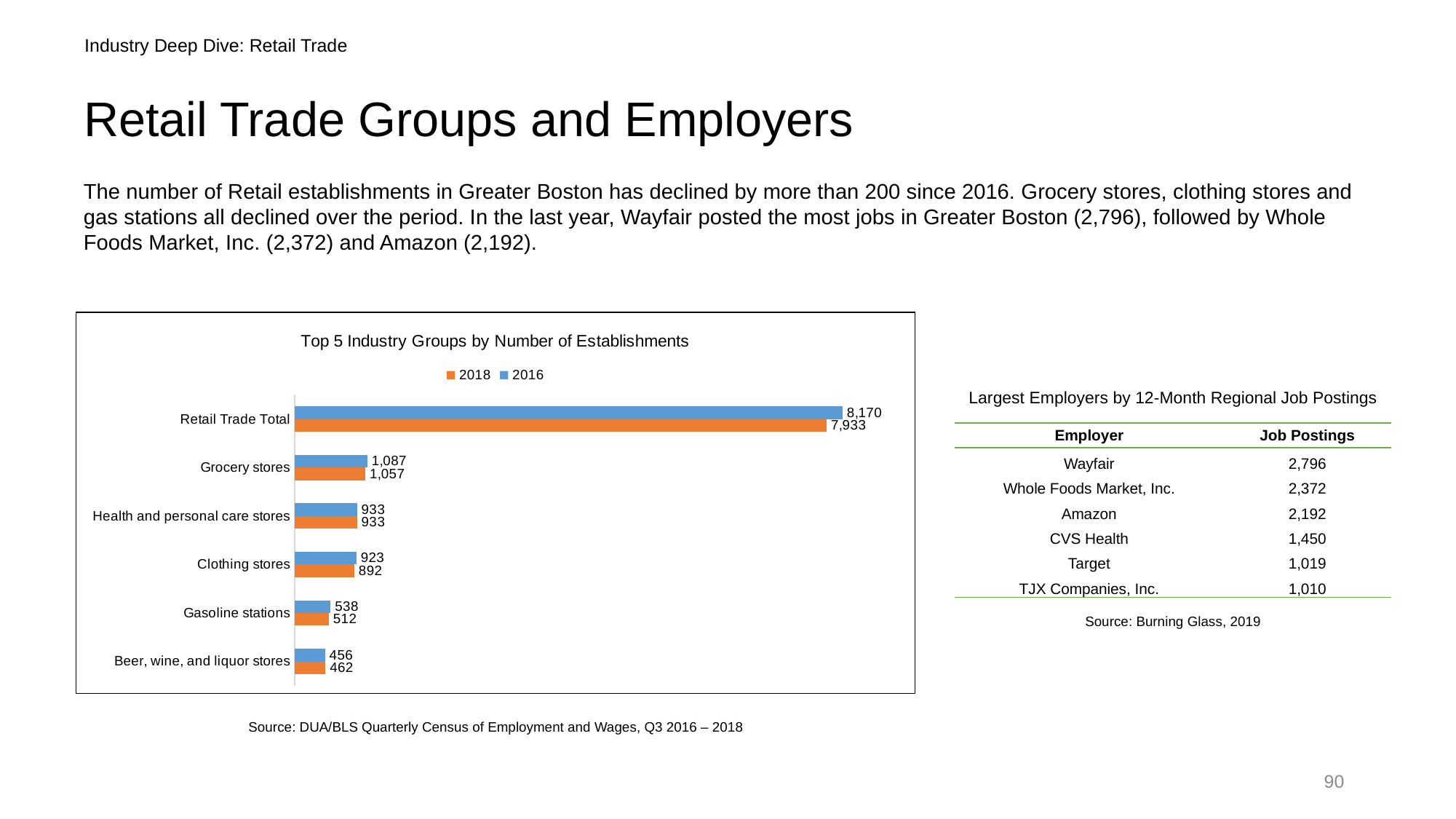
How many gasoline station establishments were there in 2016? 538 How many categories are shown on the chart? 6 What type of chart is used to show the Top 5 Industry Groups by Number of Establishments? Bar chart Which industry group had the fewest establishments in 2018? Beer, wine, and liquor stores How many series does the legend list? 2 For beer, wine, and liquor stores, was the 2018 value larger or smaller than the 2016 value? larger What is the difference between the 2016 and 2018 values for Retail Trade Total? 237 What was the number of Retail Trade Total establishments in 2018? 7,933 What was the number of Retail Trade Total establishments in 2016? 8,170 How many grocery store establishments were there in 2018? 1,057 Excluding the Retail Trade Total, which industry group had the most establishments in 2016? Grocery stores By how much did the number of clothing store establishments change from 2016 to 2018? 31